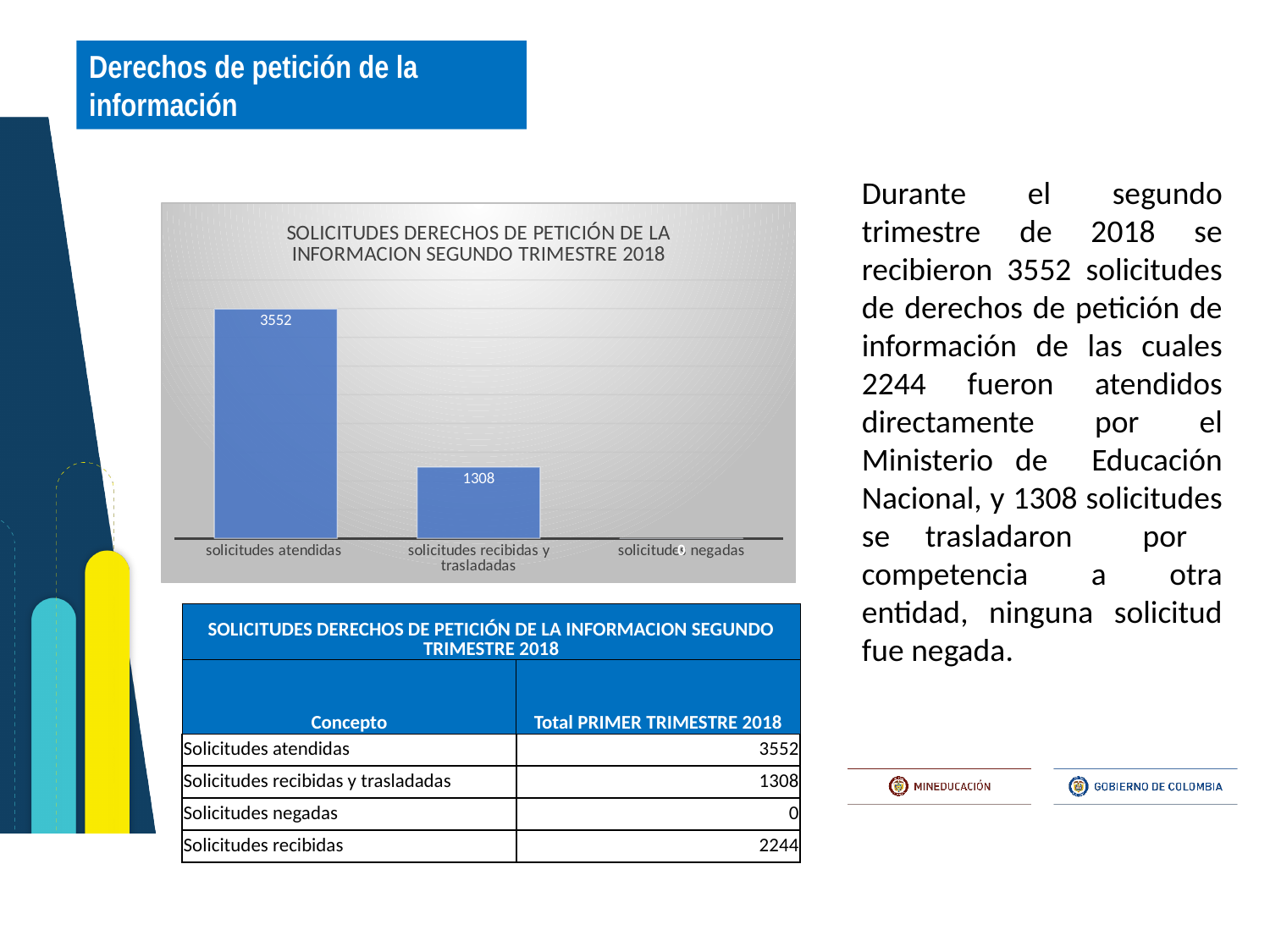
What is the value for solicitudes negadas? 0 Which category has the highest value? solicitudes atendidas What colour are the bars in the chart? blue Which category has the lowest value? solicitudes negadas What is the value for solicitudes recibidas y trasladadas? 1308 Which is larger, solicitudes atendidas or solicitudes recibidas y trasladadas? solicitudes atendidas What is the difference between solicitudes atendidas and solicitudes recibidas y trasladadas? 2244 Do the values rise or fall from left to right along the x axis? fall What is the title of the chart? SOLICITUDES DERECHOS DE PETICIÓN DE LA INFORMACION SEGUNDO TRIMESTRE 2018 What is the value for solicitudes atendidas? 3552 How many categories are shown on the x axis? 3 What kind of chart is shown? bar chart